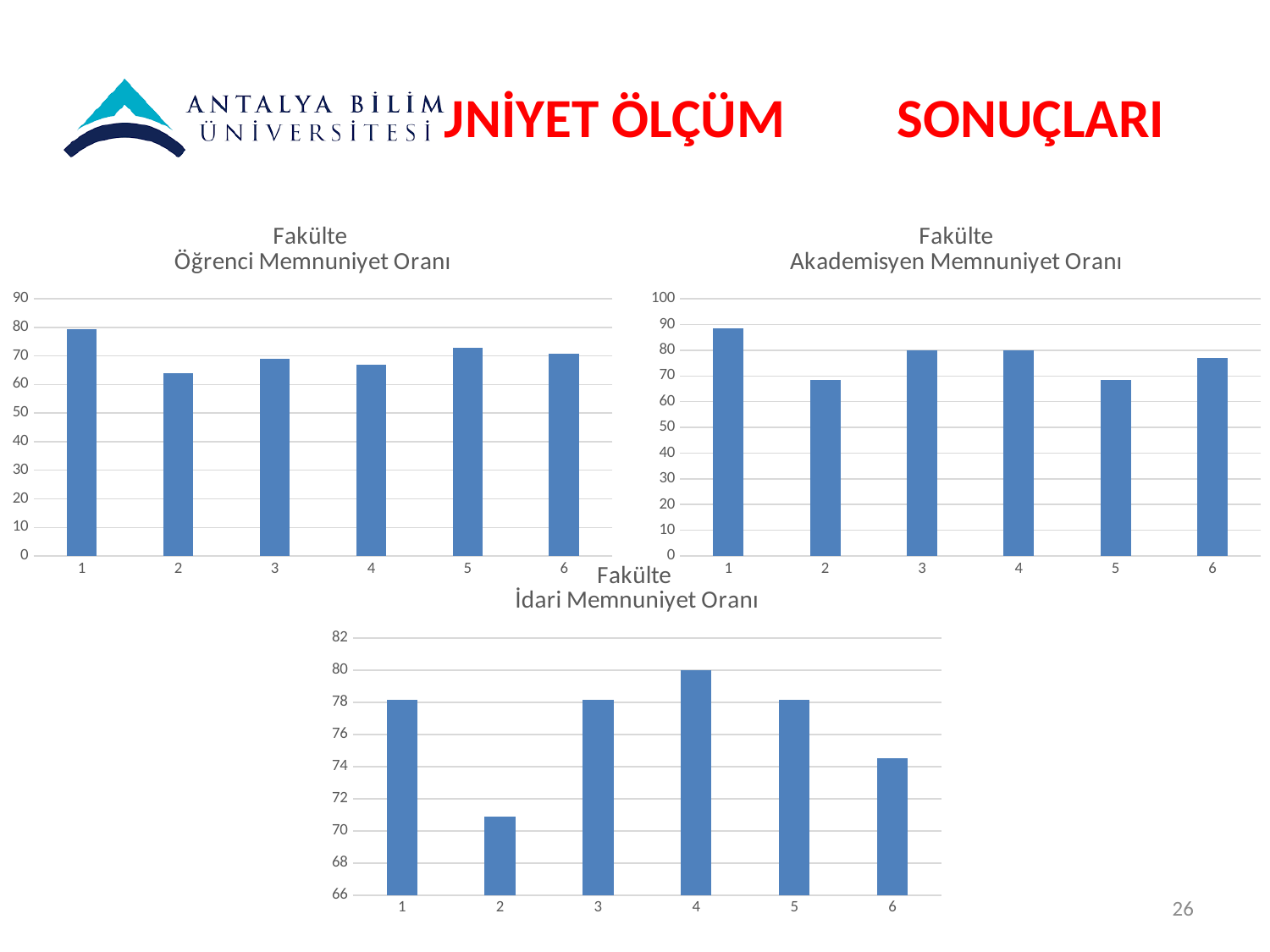
In the chart titled "Fakülte Öğrenci Memnuniyet Oranı", is the value for category 2 greater or less than 70? less In the chart titled "Fakülte Öğrenci Memnuniyet Oranı", is the value for category 1 greater or less than 70? greater In the chart titled "Fakülte Öğrenci Memnuniyet Oranı", which category has the lowest value? 2 What kind of chart is the one titled "Fakülte Akademisyen Memnuniyet Oranı"? bar chart How many categories are shown on the x axis of the chart titled "Fakülte İdari Memnuniyet Oranı"? 6 In the chart titled "Fakülte Öğrenci Memnuniyet Oranı", which category has the highest value? 1 In the chart titled "Fakülte Akademisyen Memnuniyet Oranı", is the value for category 1 greater or less than 80? greater In the chart titled "Fakülte İdari Memnuniyet Oranı", which category has the lowest value? 2 In the chart titled "Fakülte Akademisyen Memnuniyet Oranı", which category has the highest value? 1 In the chart titled "Fakülte Akademisyen Memnuniyet Oranı", which is larger, the value for category 3 or the value for category 5? 3 In the chart titled "Fakülte İdari Memnuniyet Oranı", which category has the highest value? 4